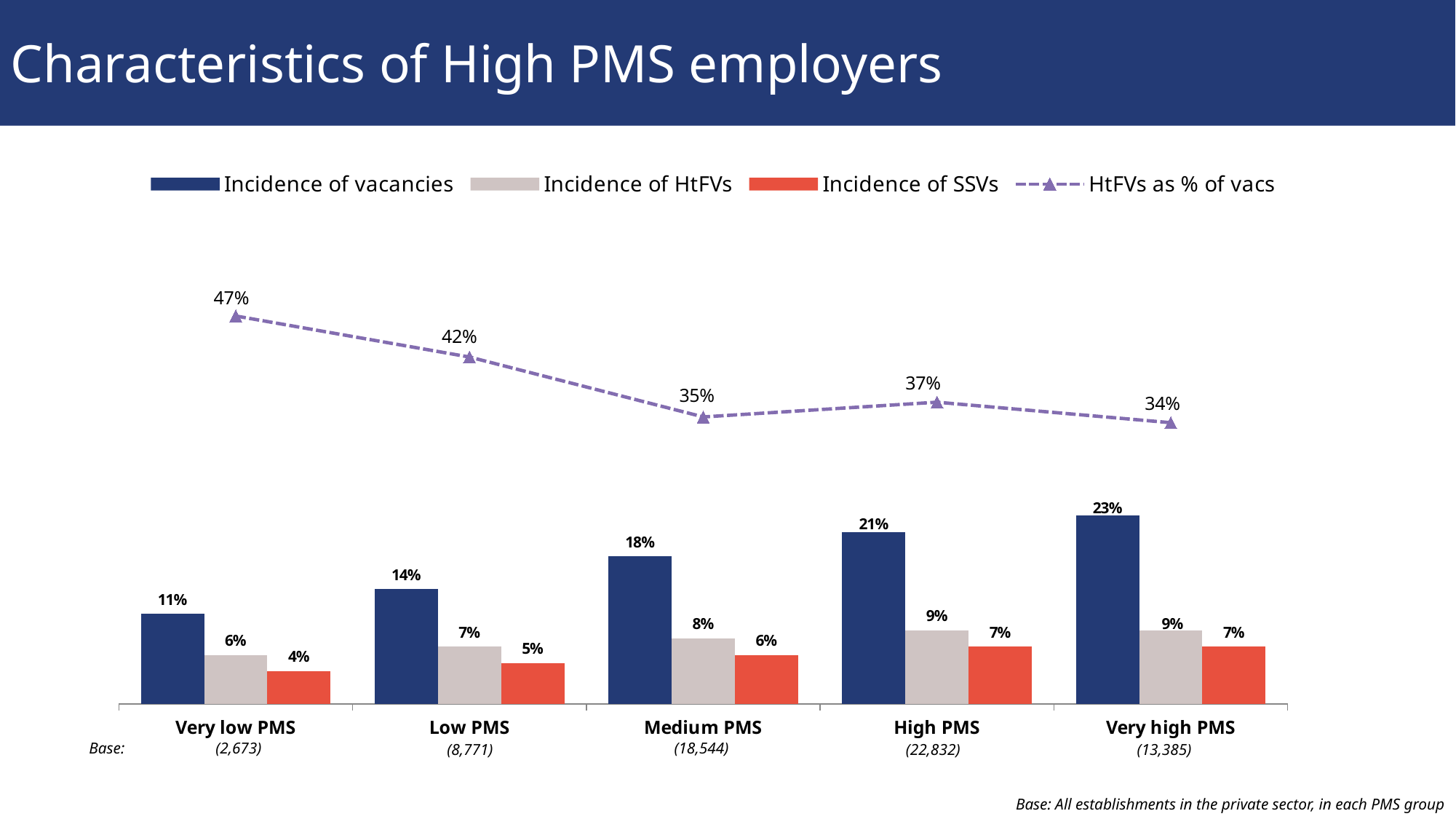
Does the Incidence of vacancies rise or fall from Very low PMS to Very high PMS? Rise Which PMS group has the lowest HtFVs as % of vacs? Very high PMS What is the difference between the Incidence of vacancies for High PMS and Very low PMS? 10% Which PMS group has the highest Incidence of vacancies? Very high PMS How many series does the legend list? 4 What is the base (number of establishments) for the Medium PMS group? 18,544 What kind of chart is shown on the slide? Combined bar and line chart How many PMS groups are shown on the x axis? 5 What is the Incidence of vacancies for Very high PMS? 23% Which is larger: the Incidence of HtFVs for Low PMS or for Medium PMS? Medium PMS What is the HtFVs as % of vacs value for Medium PMS? 35% What is the Incidence of SSVs for Very low PMS? 4%